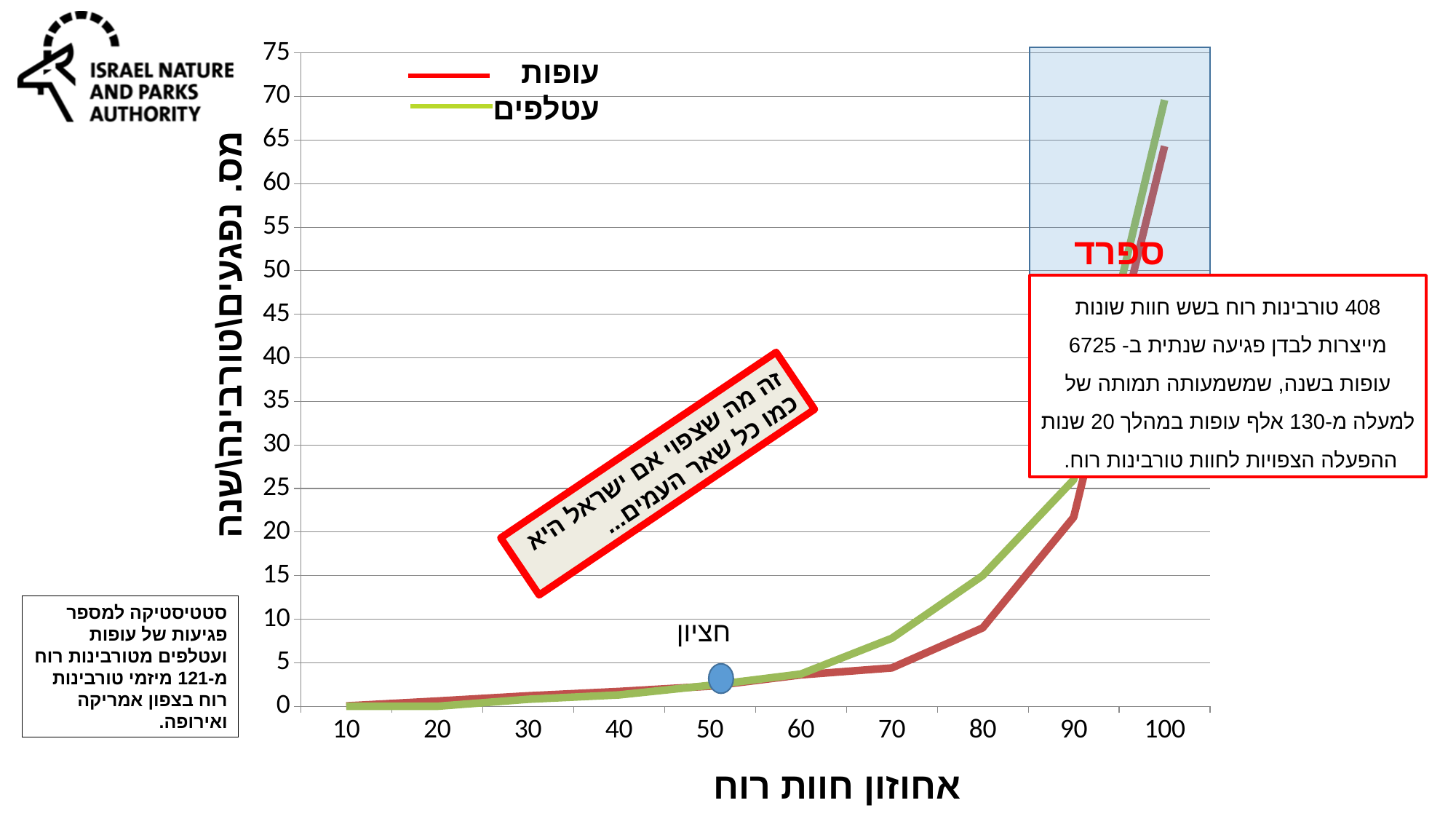
Is the value for עופות at x = 90 greater or less than 20? greater At x = 100, which series has the larger value, עופות or עטלפים? עטלפים At x = 80, which series has the larger value, עופות or עטלפים? עטלפים What are the two series named in the legend? עופות and עטלפים What is the title of the x axis? אחוזון חוות רוח How many series does the chart legend list? 2 Is the value for עטלפים at x = 100 greater or less than 65? greater How many tick labels are shown on the x axis? 10 Which series reaches the highest value on the chart, עופות or עטלפים? עטלפים Is the value for עופות at x = 80 greater or less than 10? less Do the values for עטלפים rise or fall as the x axis goes from 10 to 100? rise What kind of chart is shown on the slide? line chart